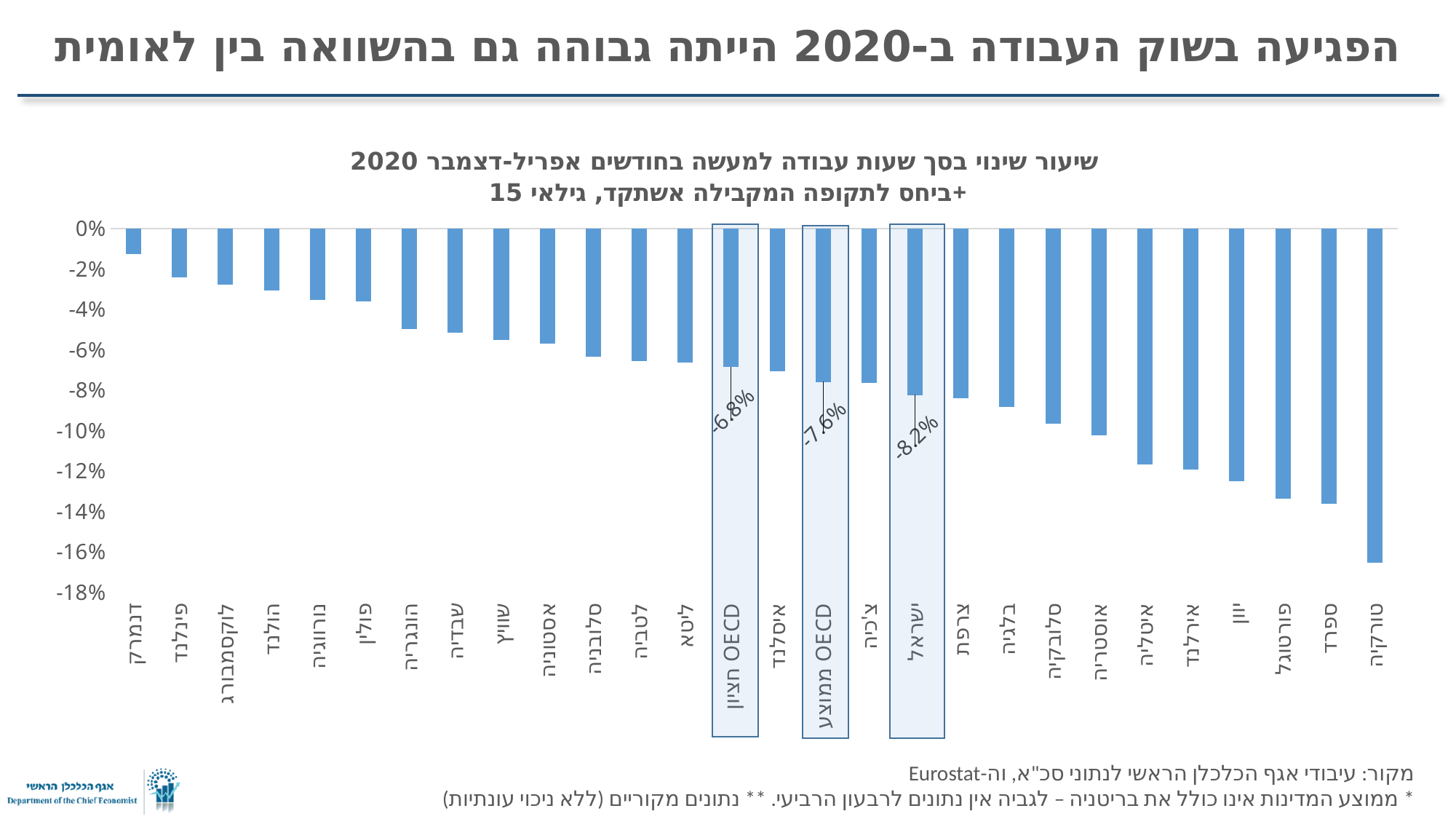
What is the difference in percentage points between the value for ישראל and the value for OECD חציון? 1.4 percentage points Which has the larger decline, ספרד or איטליה? ספרד What kind of chart is shown on the slide? Bar chart Which country has the smallest decline (highest value) in the chart? דנמרק How many categories (bars) are shown in the chart? 28 Is the value for דנמרק greater or less than -2%? greater What is the difference in percentage points between the value for ישראל and the value for OECD ממוצע? 0.6 percentage points What is the value shown for ישראל? -8.2% What is the value shown for OECD ממוצע? -7.6% Is the value for טורקיה greater or less than -16%? less Which country has the largest decline (lowest value) in the chart? טורקיה What is the value shown for OECD חציון? -6.8%